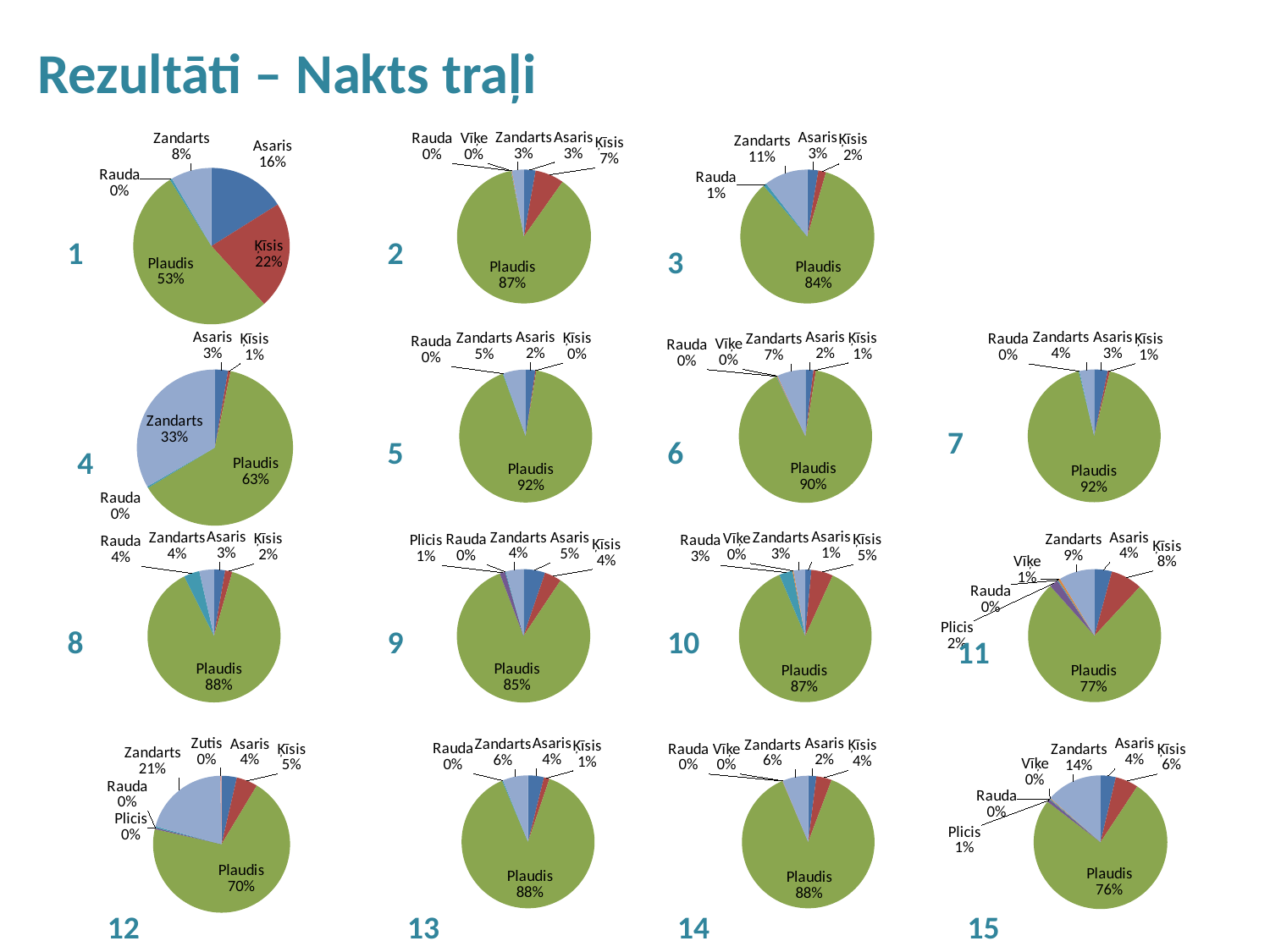
In pie chart 12, what share does Plaudis have? 70% In pie chart 9, what share does Plicis have? 1% In pie chart 4, what share does Zandarts have? 33% What type of chart is used for chart 7? Pie chart In pie chart 11, which category has the largest slice? Plaudis In pie chart 15, what is the difference between the Zandarts share and the Ķīsis share? 8% How many pie charts are shown on the slide? 15 In pie chart 12, how many categories are labelled? 7 In pie chart 1, which is larger, Asaris or Ķīsis? Ķīsis What is the title of the slide? Rezultāti – Nakts traļi